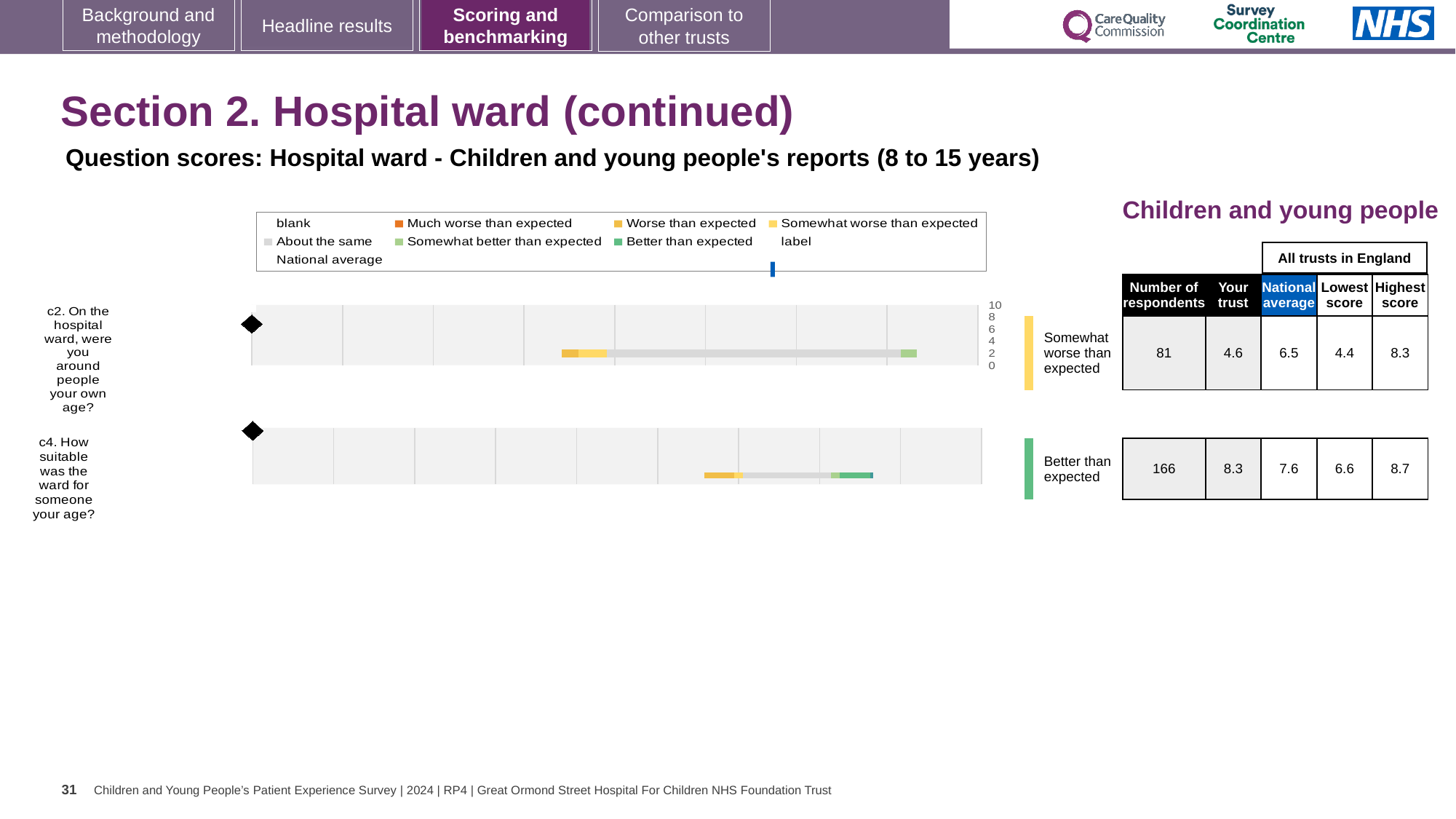
What is the 'Your trust' score for c2 (On the hospital ward, were you around people your own age?)? 4.6 How many respondents answered question c4? 166 What benchmark category is shown for question c4? Better than expected What is the 'Your trust' score for c4 (How suitable was the ward for someone your age?)? 8.3 How many questions are plotted in the chart on this slide? 2 Which question has the higher 'Your trust' score, c2 or c4? c4 What is the difference between the national average and the trust's score for c2? 1.9 What kind of chart is used to show the question scores for c2 and c4? bar chart What is the highest score among all trusts in England for c4? 8.7 By how much does the trust's score for c4 exceed the national average for c4? 0.7 What benchmark category is shown for question c2? Somewhat worse than expected What is the national average score for c2? 6.5